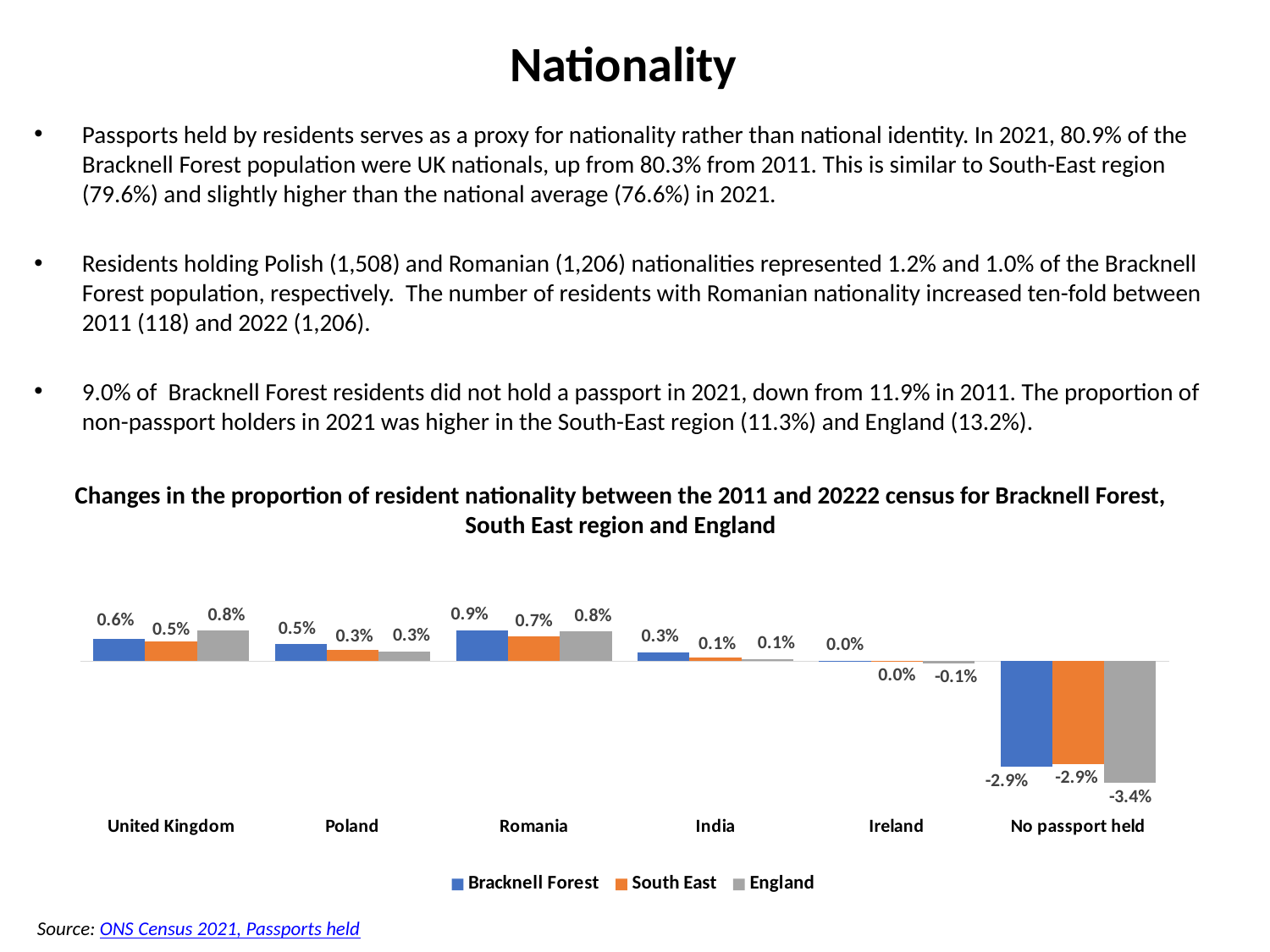
What is the difference between the England and Bracknell Forest values in the United Kingdom category? 0.2% What is the value for England in the No passport held category? -3.4% Which series is shown in orange in the legend? South East Which category has the highest value for Bracknell Forest? Romania What kind of chart is shown on the slide? Bar chart How many series does the legend list? 3 Which category has the lowest value for England? No passport held What is the value for South East in the Poland category? 0.3% Which is larger in the India category: the Bracknell Forest value or the South East value? Bracknell Forest How many categories are shown on the x axis? 6 What is the value for England in the Ireland category? -0.1% What is the value for Bracknell Forest in the Romania category? 0.9%